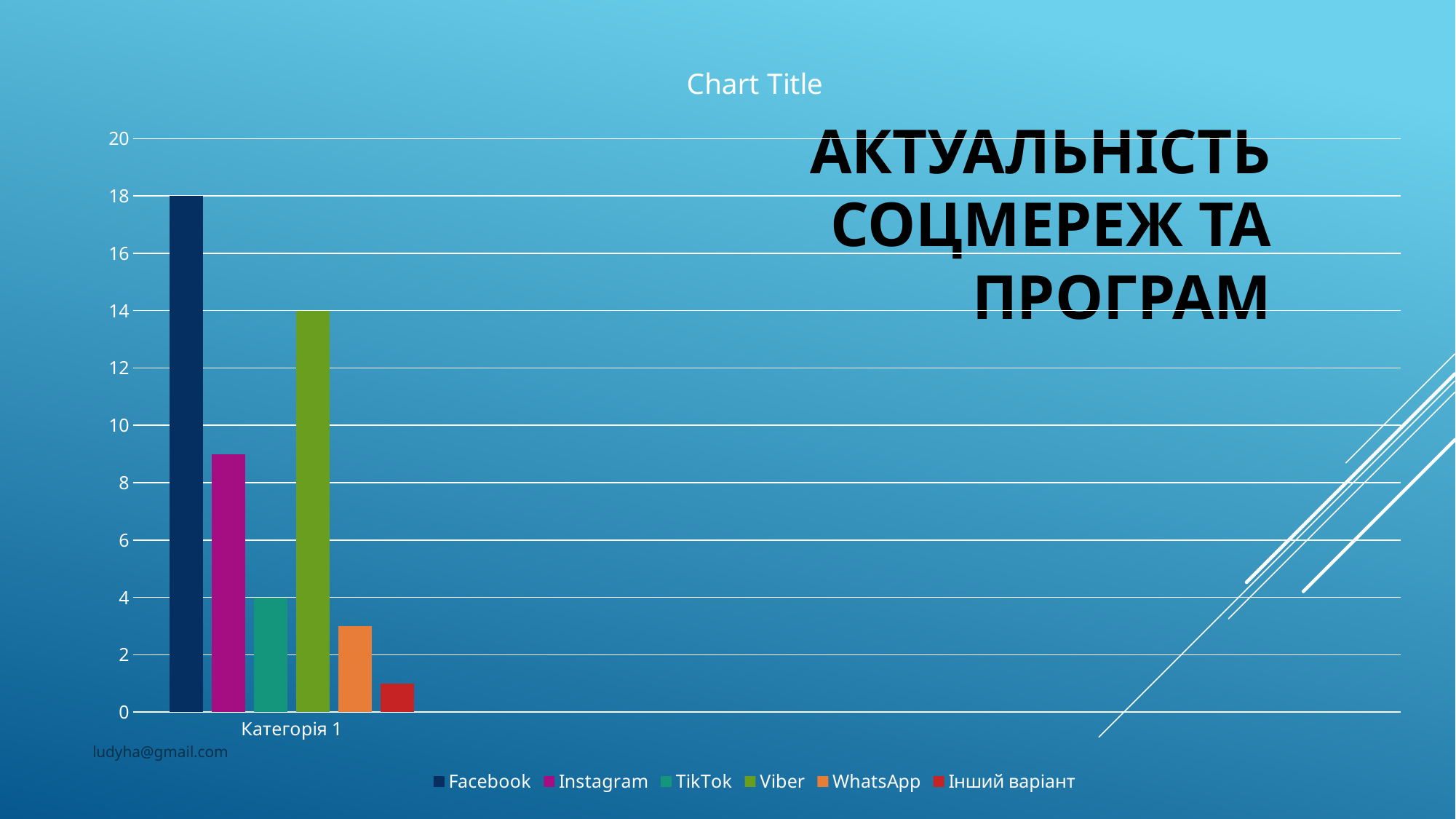
Which series has the highest bar? Facebook Which is larger, the Instagram bar or the Viber bar? Viber Is the value for Instagram greater or less than 10? less What is the difference between the Facebook and Viber values? 4 Is the value for WhatsApp greater or less than 2? greater What type of chart is shown on the slide? bar chart What is the value of the TikTok bar? 4 What is the value of the Viber bar? 14 Which series has the lowest bar? Інший варіант What is the category label shown on the x axis? Категорія 1 What is the value of the Facebook bar? 18 How many series does the legend list? 6